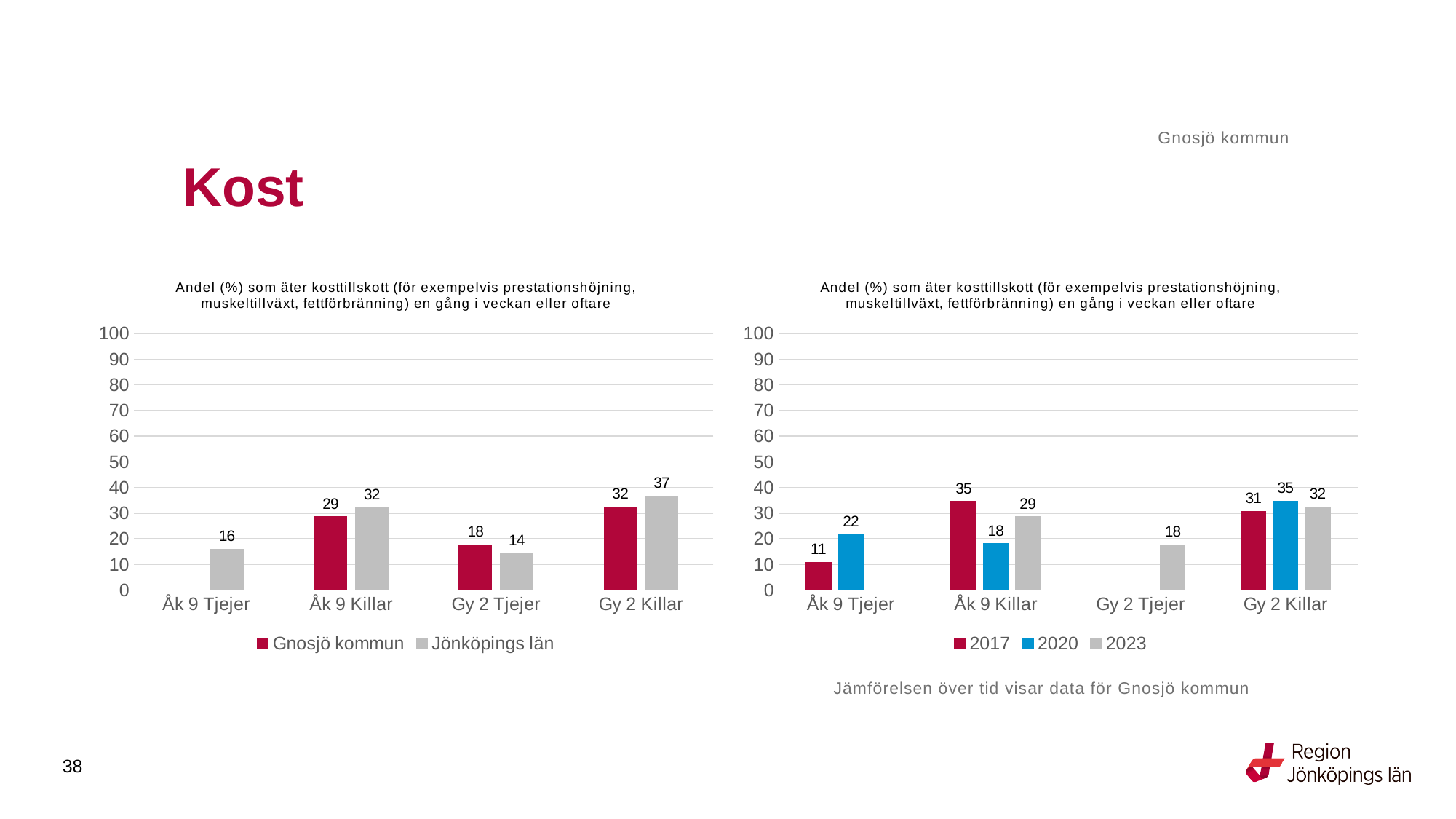
In the left chart, which category has the highest value for Jönköpings län? Gy 2 Killar In the left chart, what is the value for Gnosjö kommun for Gy 2 Tjejer? 18 In the left chart, what is the difference between Jönköpings län and Gnosjö kommun for Åk 9 Killar? 3 In the right chart, what is the value for 2020 for Åk 9 Tjejer? 22 In the left chart, what is the value for Jönköpings län for Gy 2 Killar? 37 In the right chart, what is the difference between the 2017 and 2020 values for Åk 9 Killar? 17 In the left chart, which is larger for Gy 2 Tjejer: Gnosjö kommun or Jönköpings län? Gnosjö kommun In the right chart, what is the value for 2017 for Åk 9 Killar? 35 What type of chart is the right chart? Bar chart How many series does the legend of the right chart list? 3 In the right chart, which category has the lowest value for 2017? Åk 9 Tjejer How many series does the legend of the left chart list? 2